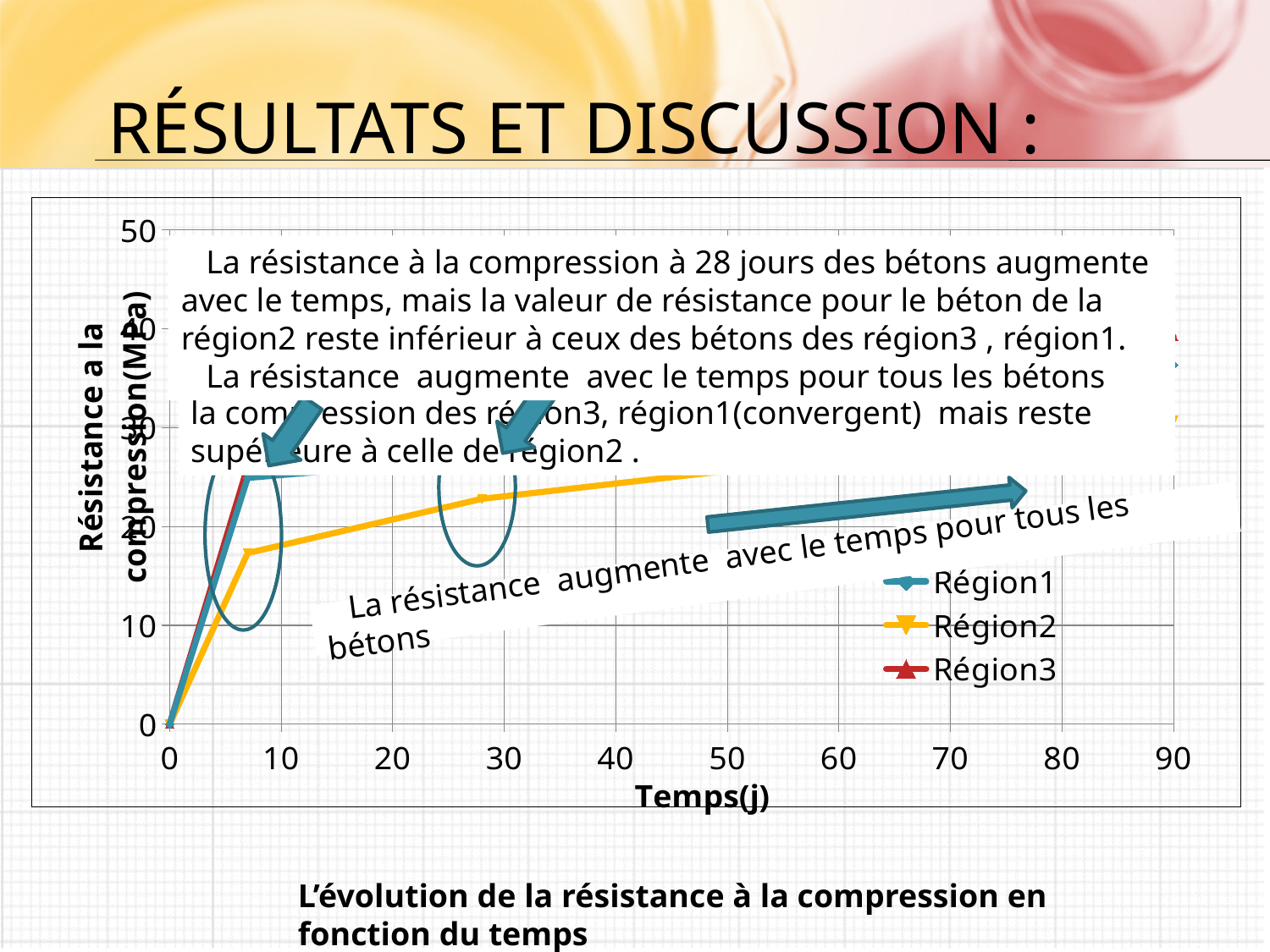
What are the names of the series listed in the chart legend? Région1, Région2, Région3 What kind of chart is shown on the slide? line chart How many series does the chart legend list? 3 What is the highest value shown on the x axis of the chart? 90 At about 7 days, which series has the larger value, Région1 or Région2? Région1 Is the value for Région2 at about 28 days greater or less than 20? greater Do the values for Région2 rise or fall as time increases along the x axis? rise What is the highest value shown on the y axis of the chart? 50 What is the title of the x axis of the chart? Temps(j) Is the value for Région2 at about 7 days greater or less than 20? less What value do all three series start at when time is 0? 0